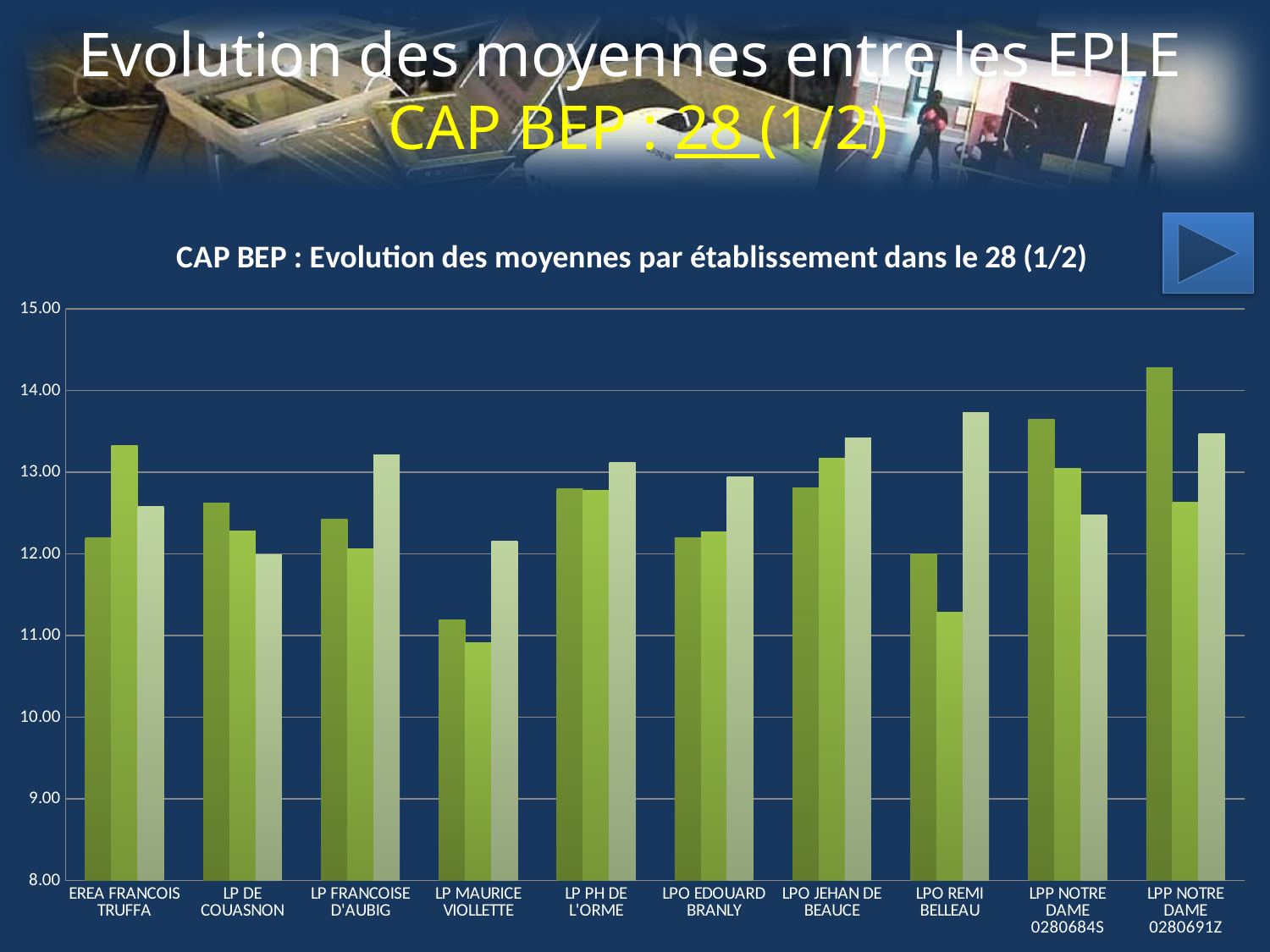
Is the value of the second (middle) bar for LPO REMI BELLEAU greater or less than 12.00? less What is the lowest value shown on the vertical axis of the chart? 8.00 How many establishments are shown on the x axis of the chart? 10 What is the title of the chart? CAP BEP : Evolution des moyennes par établissement dans le 28 (1/2) Which establishment has the shortest bar in the chart? LP MAURICE VIOLLETTE Is the value of the first (leftmost) bar for LP MAURICE VIOLLETTE greater or less than 12.00? less Is the value of the first (leftmost) bar for LPP NOTRE DAME 0280691Z greater or less than 14.00? greater How many bars are plotted for each establishment? 3 Which is larger: the first (leftmost) bar for LPP NOTRE DAME 0280691Z or the first (leftmost) bar for EREA FRANCOIS TRUFFA? LPP NOTRE DAME 0280691Z Which establishment has the tallest bar in the chart? LPP NOTRE DAME 0280691Z What kind of chart is shown on the slide? bar chart